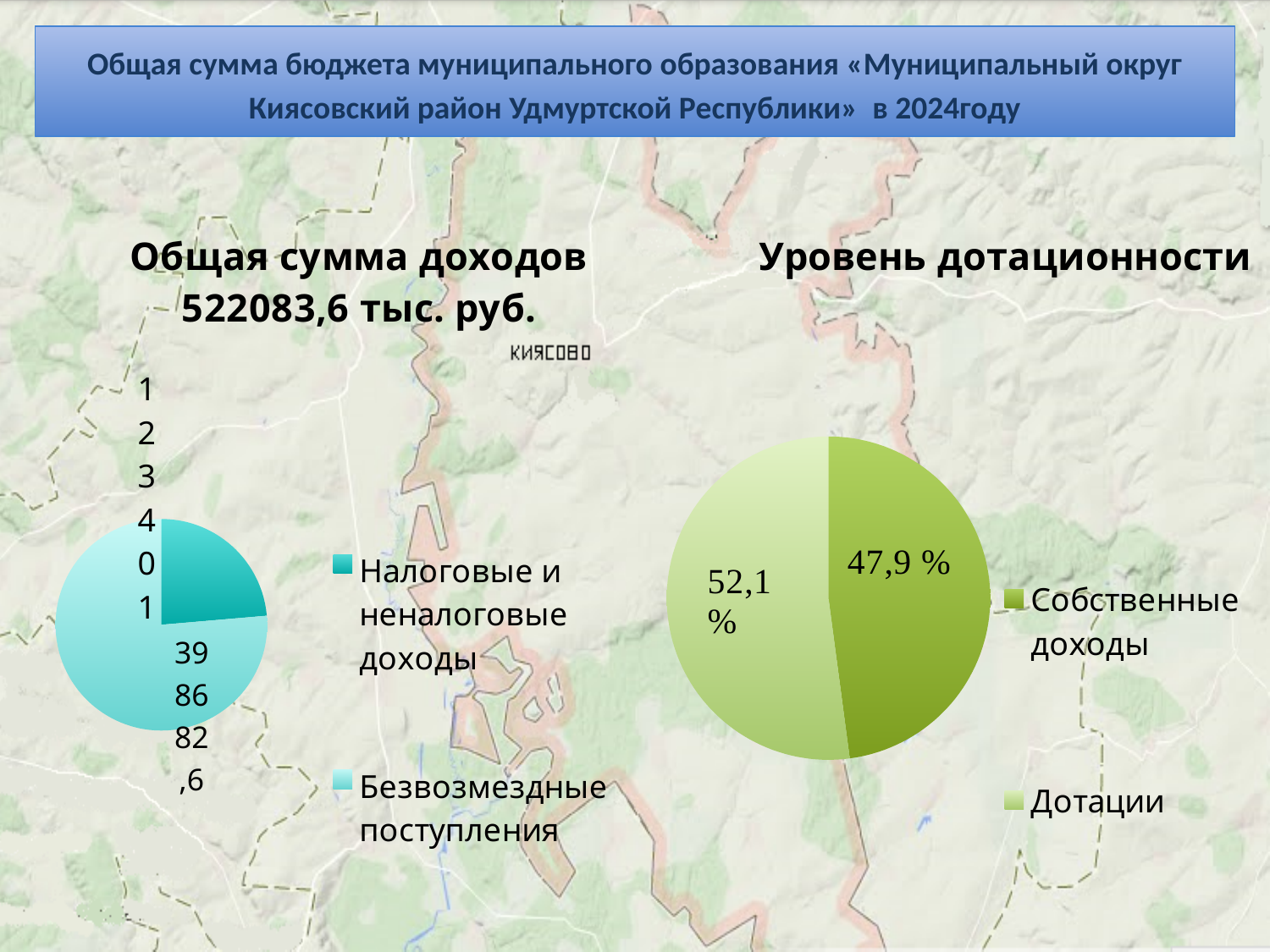
How many entries does the legend of the "Общая сумма доходов" chart list? 2 According to the title of the left chart, what is the total sum of revenues (Общая сумма доходов)? 522083,6 тыс. руб. What kind of chart is the "Общая сумма доходов" chart on the left? pie chart What kind of chart is the "Уровень дотационности" chart on the right? pie chart In the "Уровень дотационности" chart, what is the difference between the Дотации and Собственные доходы shares? 4,2 % In the "Уровень дотационности" chart, which slice is larger: Собственные доходы or Дотации? Дотации In the "Уровень дотационности" chart, what is the value for Дотации? 52,1 % How many slices does the "Уровень дотационности" pie chart have? 2 In the "Общая сумма доходов" chart, what is the value for Налоговые и неналоговые доходы? 123401 In the "Уровень дотационности" chart, what is the value for Собственные доходы? 47,9 % In the "Общая сумма доходов" chart, which slice is larger: Налоговые и неналоговые доходы or Безвозмездные поступления? Безвозмездные поступления In the "Общая сумма доходов" chart, what is the value for Безвозмездные поступления? 398682,6